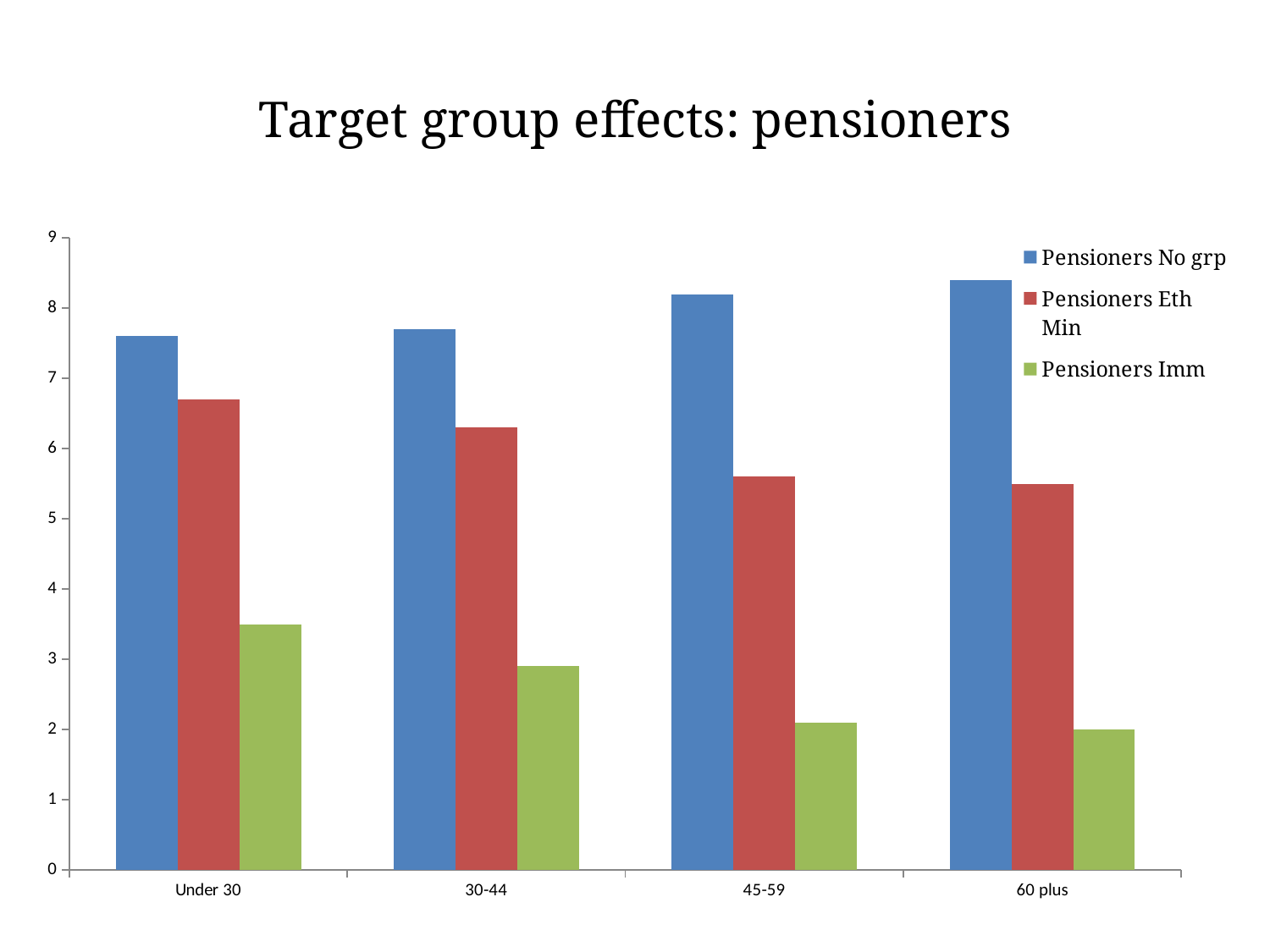
How many series does the legend list? 3 What kind of chart is shown on the slide? bar chart Which age category has the highest value for Pensioners No grp? 60 plus Is the value for Pensioners Eth Min in the 30-44 category greater or less than 6? greater Is the value for Pensioners Imm in the Under 30 category greater or less than 3? greater Do the values for Pensioners Imm rise or fall across the age categories from Under 30 to 60 plus? fall Which age category has the highest value for Pensioners Eth Min? Under 30 Which is larger in the Under 30 category: Pensioners No grp or Pensioners Eth Min? Pensioners No grp Is the value for Pensioners No grp in the 60 plus category greater or less than 8? greater How many age categories are shown on the x axis? 4 Which age category has the lowest value for Pensioners Imm? 60 plus